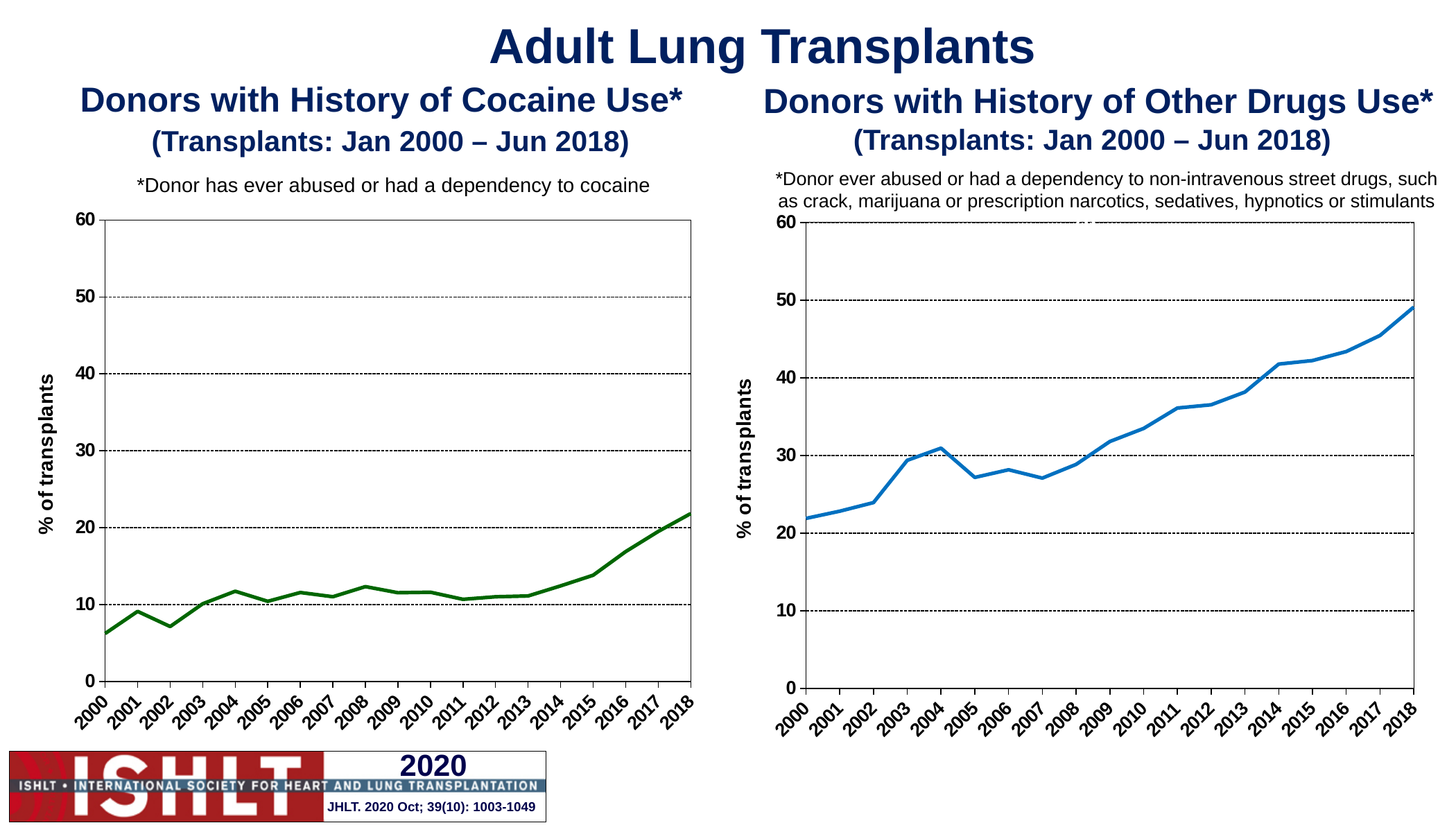
What kind of chart is the 'Donors with History of Cocaine Use' chart? line chart How many years are plotted on the x axis of the 'Donors with History of Other Drugs Use' chart? 19 In the 'Donors with History of Other Drugs Use' chart, which year has the lowest % of transplants? 2000 In the 'Donors with History of Other Drugs Use' chart, which year has the larger value, 2004 or 2005? 2004 In the 'Donors with History of Cocaine Use' chart, which year has the highest % of transplants? 2018 In the 'Donors with History of Cocaine Use' chart, which year has the lowest % of transplants? 2000 In the 'Donors with History of Other Drugs Use' chart, do the values generally rise or fall from 2008 to 2018? rise In the 'Donors with History of Cocaine Use' chart, is the value for 2000 greater or less than 10? less In the 'Donors with History of Other Drugs Use' chart, which year has the highest % of transplants? 2018 In the 'Donors with History of Cocaine Use' chart, is the value for 2018 greater or less than 20? greater